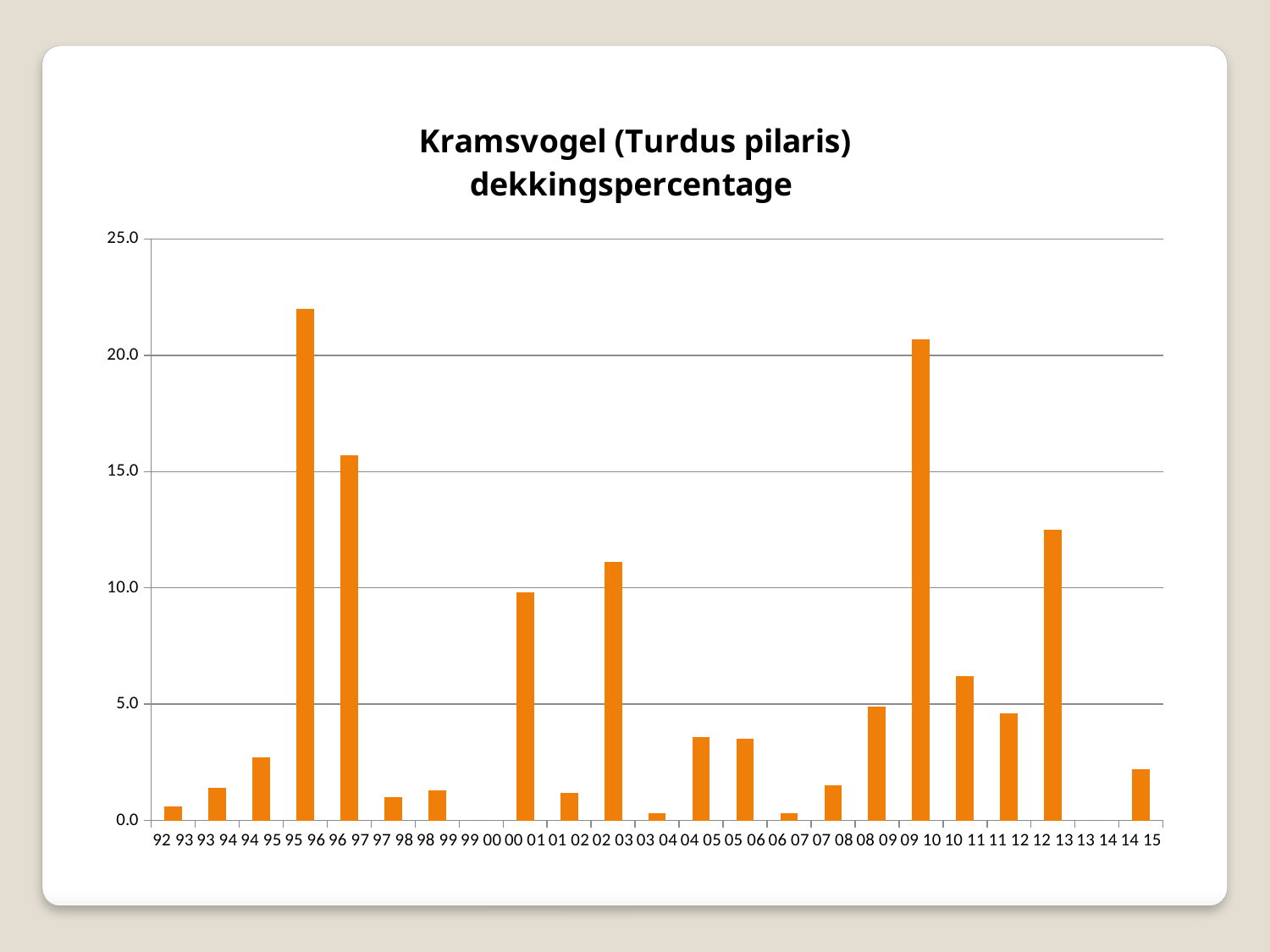
Which season has the highest dekkingspercentage? 95 96 Is the value for 96 97 greater or less than 15.0? greater How many seasons are labelled on the x axis? 23 Which is larger, the value for 10 11 or the value for 11 12? 10 11 Is the value for 02 03 greater or less than 10.0? greater Is the value for 95 96 greater or less than 20.0? greater What kind of chart is shown on the slide? bar chart What is the title of the chart? Kramsvogel (Turdus pilaris) dekkingspercentage Which is larger, the value for 09 10 or the value for 12 13? 09 10